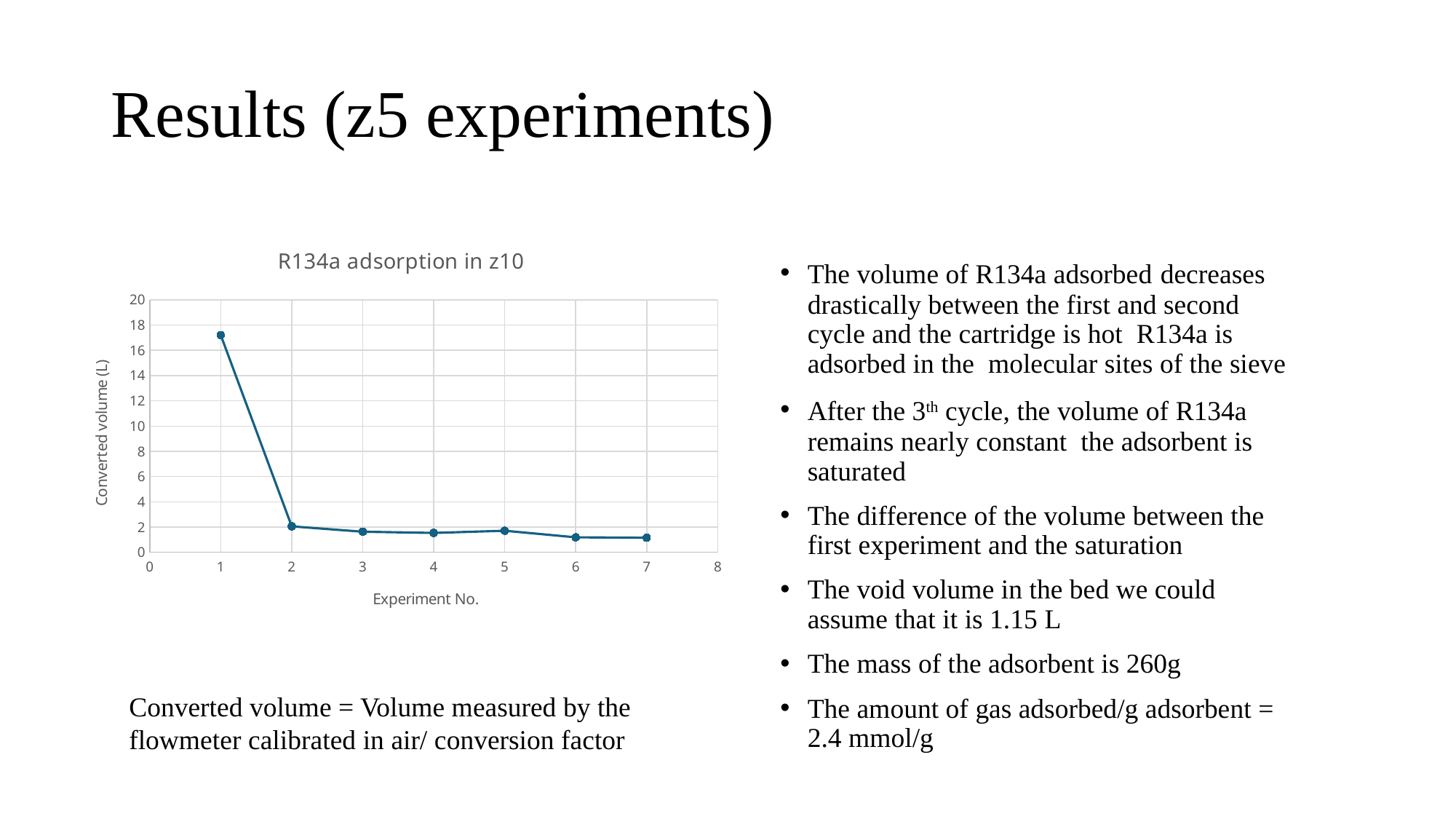
Which experiment number has the highest converted volume? 1 What is the label of the y axis of the chart? Converted volume (L) Is the converted volume for experiment 1 greater or less than 16? greater Is the converted volume for experiment 7 greater or less than 2? less Which has a larger converted volume, experiment 1 or experiment 2? experiment 1 What is the title of the chart? R134a adsorption in z10 What kind of chart is shown on the slide? line chart How many data points are plotted in the chart? 7 Is the converted volume for experiment 1 greater or less than 18? less Which has a larger converted volume, experiment 2 or experiment 6? experiment 2 Do the converted volume values generally rise or fall as the experiment number increases? fall